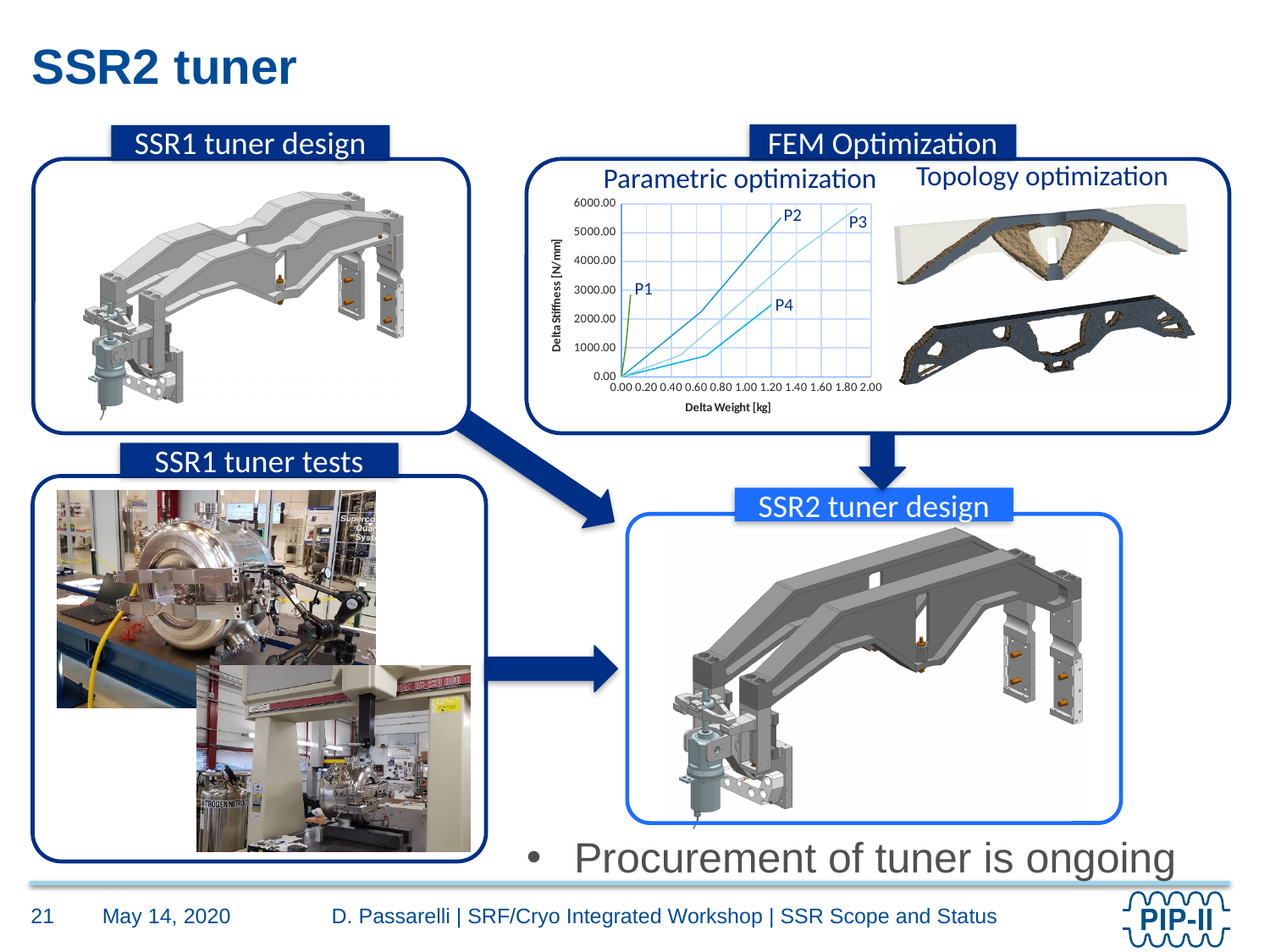
In the Parametric optimization chart, is the highest Delta Stiffness reached by P1 greater or less than 4000? less In the Parametric optimization chart, at a Delta Weight of 1.20 kg, which series has the higher Delta Stiffness, P2 or P4? P2 In the Parametric optimization chart, is the highest Delta Stiffness reached by P2 greater or less than 5000? greater In the Parametric optimization chart, which series extends to the smallest Delta Weight? P1 In the Parametric optimization chart, is the highest Delta Stiffness reached by P4 greater or less than 3000? less In the Parametric optimization chart, does Delta Stiffness rise or fall as Delta Weight increases along the x axis for series P2? rise What kind of chart is shown under "Parametric optimization" in the FEM Optimization box? line chart In the Parametric optimization chart, which series extends to the largest Delta Weight? P3 What is the y-axis title of the Parametric optimization chart? Delta Stiffness [N/mm] In the Parametric optimization chart, what is the maximum value shown on the y axis? 6000.00 In the Parametric optimization chart, how many series (P-lines) are plotted? 4 What is the x-axis title of the Parametric optimization chart? Delta Weight [kg]